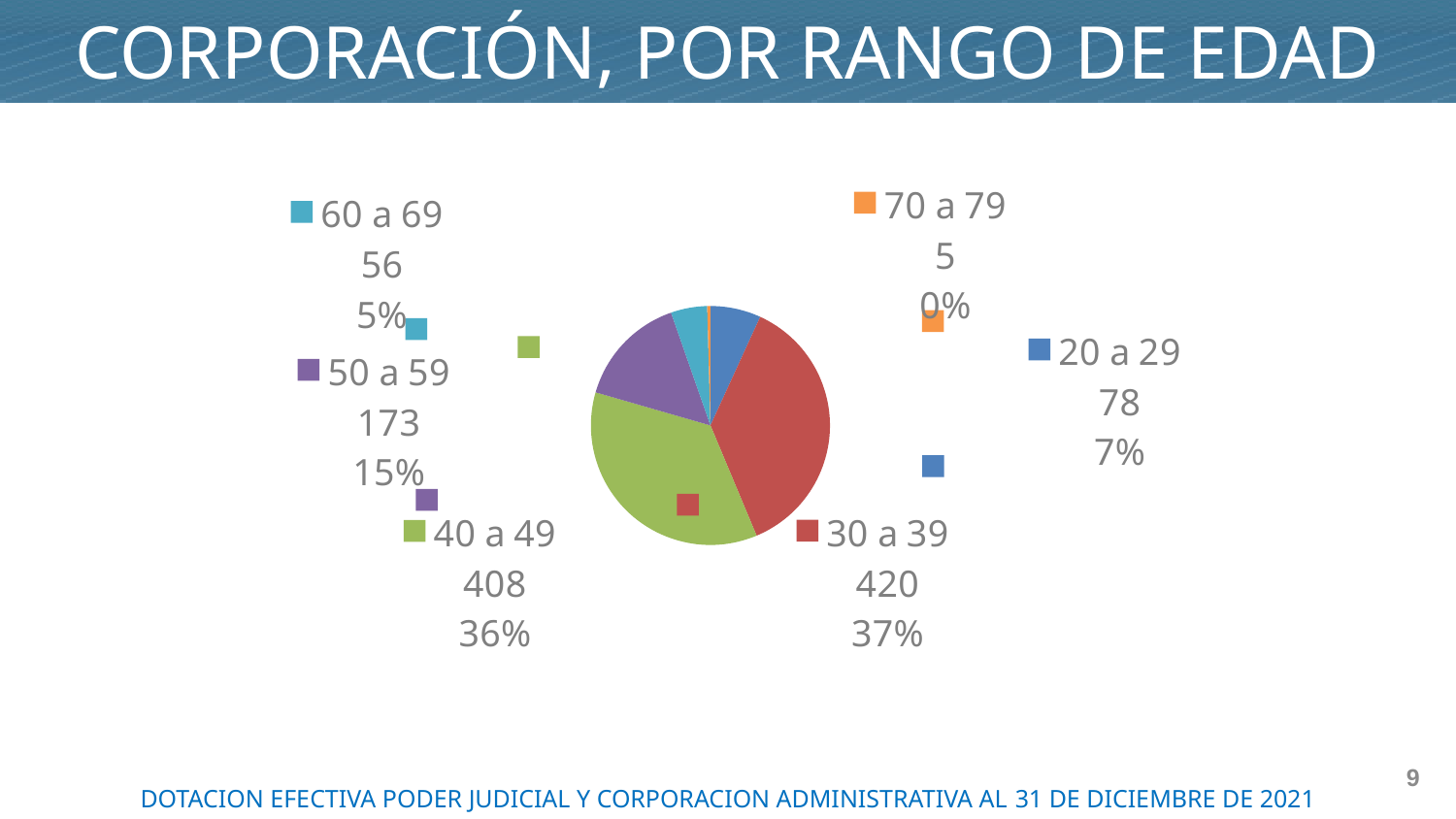
What percentage share does the 40 a 49 age range have? 36% What is the title of the slide containing the chart? CORPORACIÓN, POR RANGO DE EDAD What is the value for the 30 a 39 age range? 420 What is the value for the 50 a 59 age range? 173 Which age range has the highest value? 30 a 39 How many age-range categories does the pie chart show? 6 What is the difference between the values for 30 a 39 and 40 a 49? 12 Which age range has the lowest value? 70 a 79 What is the difference between the values for 50 a 59 and 60 a 69? 117 What percentage share does the 20 a 29 age range have? 7% Which is larger, the value for 20 a 29 or the value for 60 a 69? 20 a 29 What kind of chart is shown on the slide? pie chart